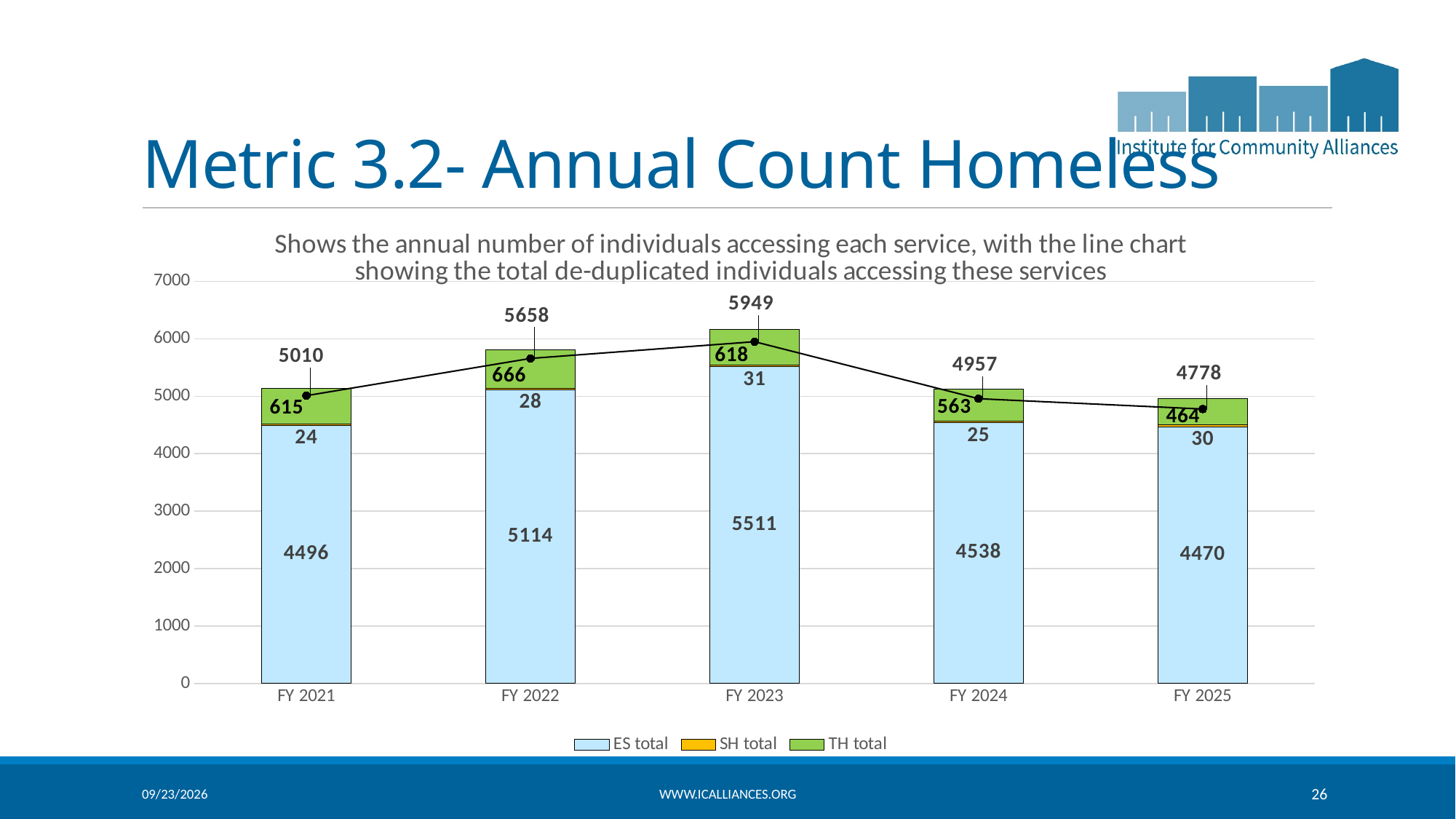
What is the difference between the ES total for FY 2022 and FY 2021? 618 What is the total height of the stacked bar for FY 2025 (ES, SH and TH combined)? 4964 Which fiscal year has the highest de-duplicated total on the line? FY 2023 What is the SH total for FY 2025? 30 How many series does the legend list? 3 What is the TH total for FY 2022? 666 How many fiscal years are shown on the x axis? 5 What is the de-duplicated total shown by the line for FY 2024? 4957 What is the ES total for FY 2023? 5511 Which is larger, the TH total for FY 2021 or for FY 2023? FY 2023 Does the de-duplicated total line rise or fall from FY 2023 to FY 2025? fall Which fiscal year has the lowest TH total? FY 2025